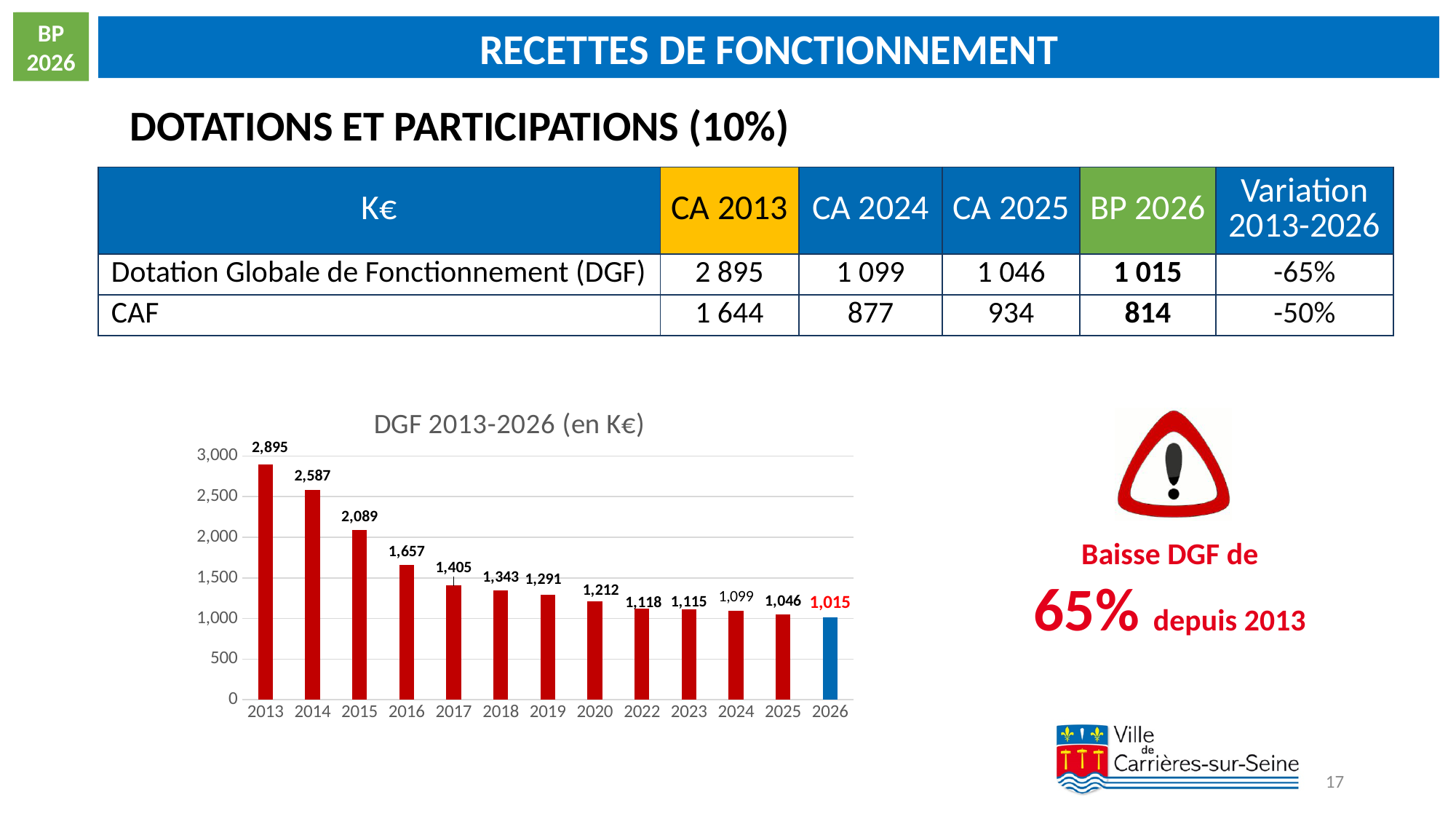
What is the DGF value for 2026 in the chart? 1,015 What type of chart is shown on the slide? bar chart What is the DGF value for 2017 in the chart? 1,405 What is the title of the chart? DGF 2013-2026 (en K€) How many bars are plotted in the chart? 13 Which is larger in the chart, the DGF value for 2015 or for 2016? 2015 Which bar in the chart is coloured blue instead of red? 2026 Do the DGF values rise or fall from 2013 to 2026 in the chart? fall Which year has the highest DGF value in the chart? 2013 Which year has the lowest DGF value in the chart? 2026 What is the difference between the DGF values for 2013 and 2026 in the chart? 1,880 What is the DGF value for 2013 in the chart? 2,895